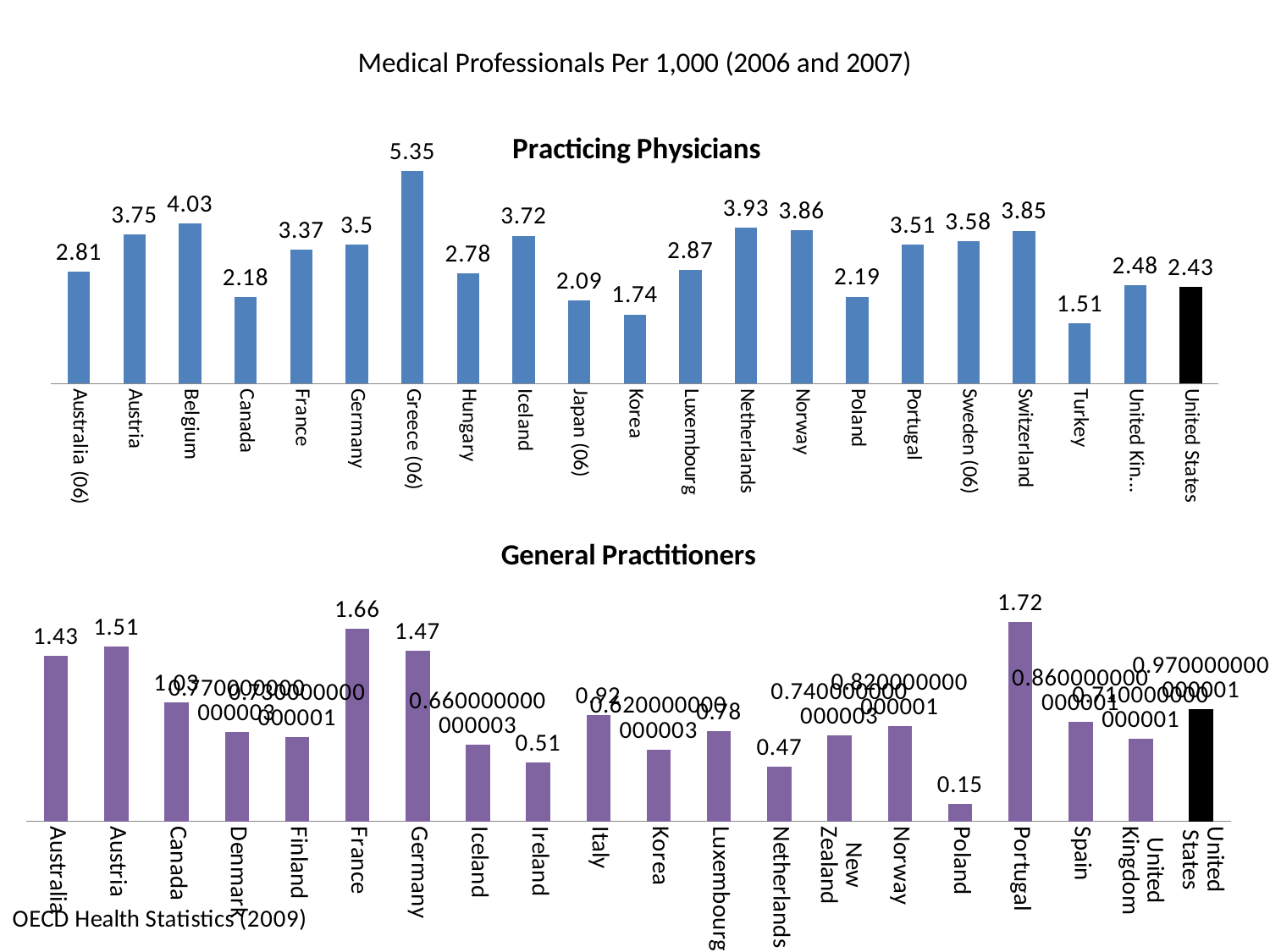
In the Practicing Physicians chart, what colour is the bar for United States? Black In the General Practitioners chart, what is the value for France? 1.66 In the General Practitioners chart, which country has the lowest value? Poland In the Practicing Physicians chart, what is the value for Greece (06)? 5.35 In the Practicing Physicians chart, which is larger, the value for Netherlands or the value for Norway? Netherlands In the Practicing Physicians chart, which country has the lowest value? Turkey In the Practicing Physicians chart, what is the difference between Belgium and Canada? 1.85 In the General Practitioners chart, which country has the highest value? Portugal What kind of chart is the Practicing Physicians chart? Bar chart How many countries are shown in the Practicing Physicians chart? 21 In the Practicing Physicians chart, which country has the highest value? Greece (06) In the General Practitioners chart, what is the difference between Austria and Australia? 0.08